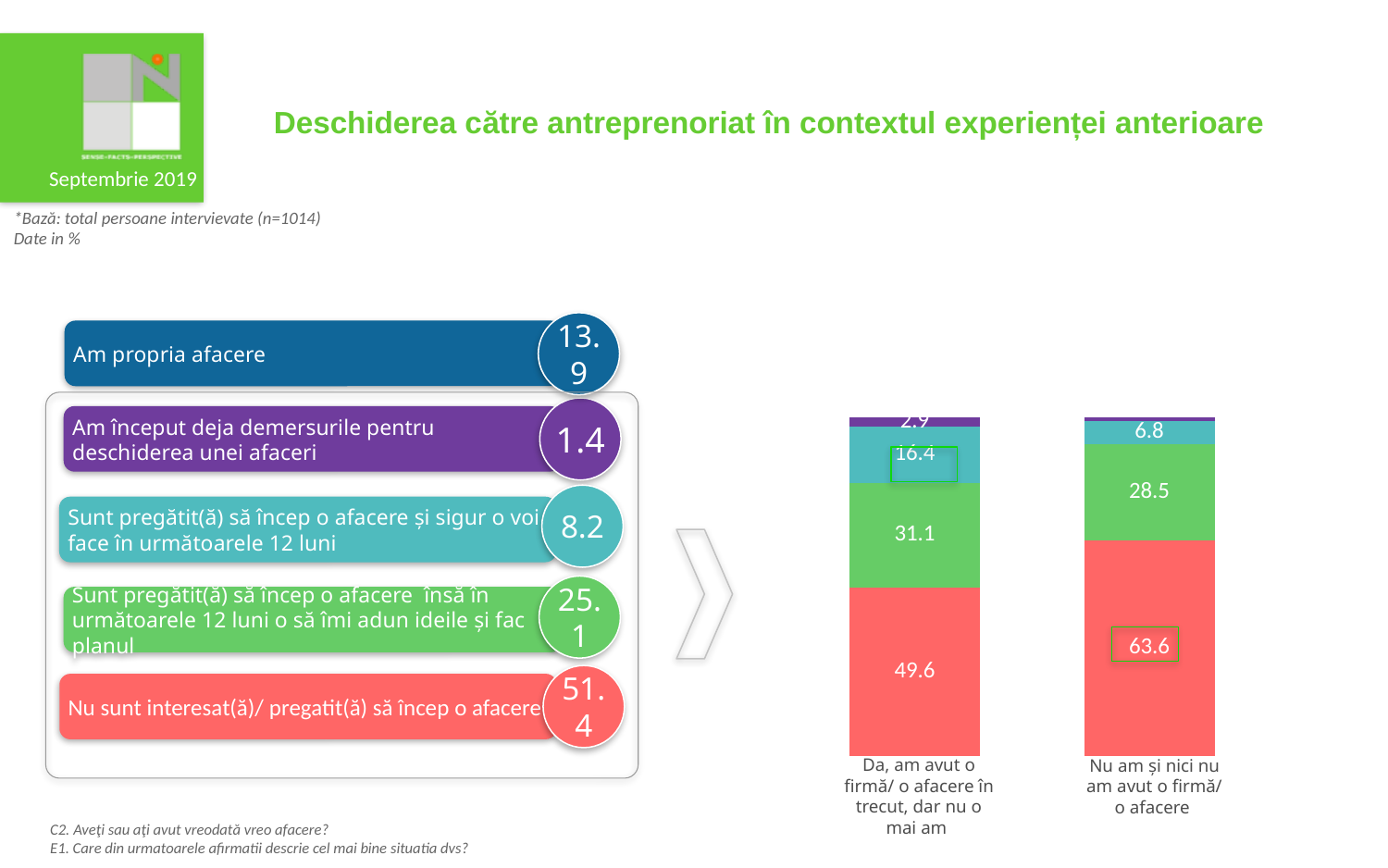
In the stacked bar chart, what is the value of the teal segment for 'Da, am avut o firmă/ o afacere în trecut, dar nu o mai am'? 16.4 In the stacked bar chart, what is the value of the green segment for 'Nu am și nici nu am avut o firmă/ o afacere'? 28.5 In the stacked bar chart, which colour is the largest segment in both bars? red In the stacked bar chart, what is the value of the top purple segment for 'Da, am avut o firmă/ o afacere în trecut, dar nu o mai am'? 2.9 In the stacked bar chart, what is the value of the red (bottom) segment for 'Da, am avut o firmă/ o afacere în trecut, dar nu o mai am'? 49.6 In the stacked bar chart, what is the total of the labelled segments for 'Da, am avut o firmă/ o afacere în trecut, dar nu o mai am' (49.6, 31.1, 16.4, 2.9)? 100.0 In the stacked bar chart, which category has the larger green segment? Da, am avut o firmă/ o afacere în trecut, dar nu o mai am What kind of chart is shown on the right side of the slide? stacked bar chart In the stacked bar chart, what is the value of the red (bottom) segment for 'Nu am și nici nu am avut o firmă/ o afacere'? 63.6 In the stacked bar chart, what is the difference between the teal segments of the two bars (16.4 and 6.8)? 9.6 In the stacked bar chart, what is the difference between the red segments of 'Nu am și nici nu am avut o firmă/ o afacere' (63.6) and 'Da, am avut o firmă/ o afacere în trecut, dar nu o mai am' (49.6)? 14.0 How many categories (bars) does the stacked bar chart show? 2